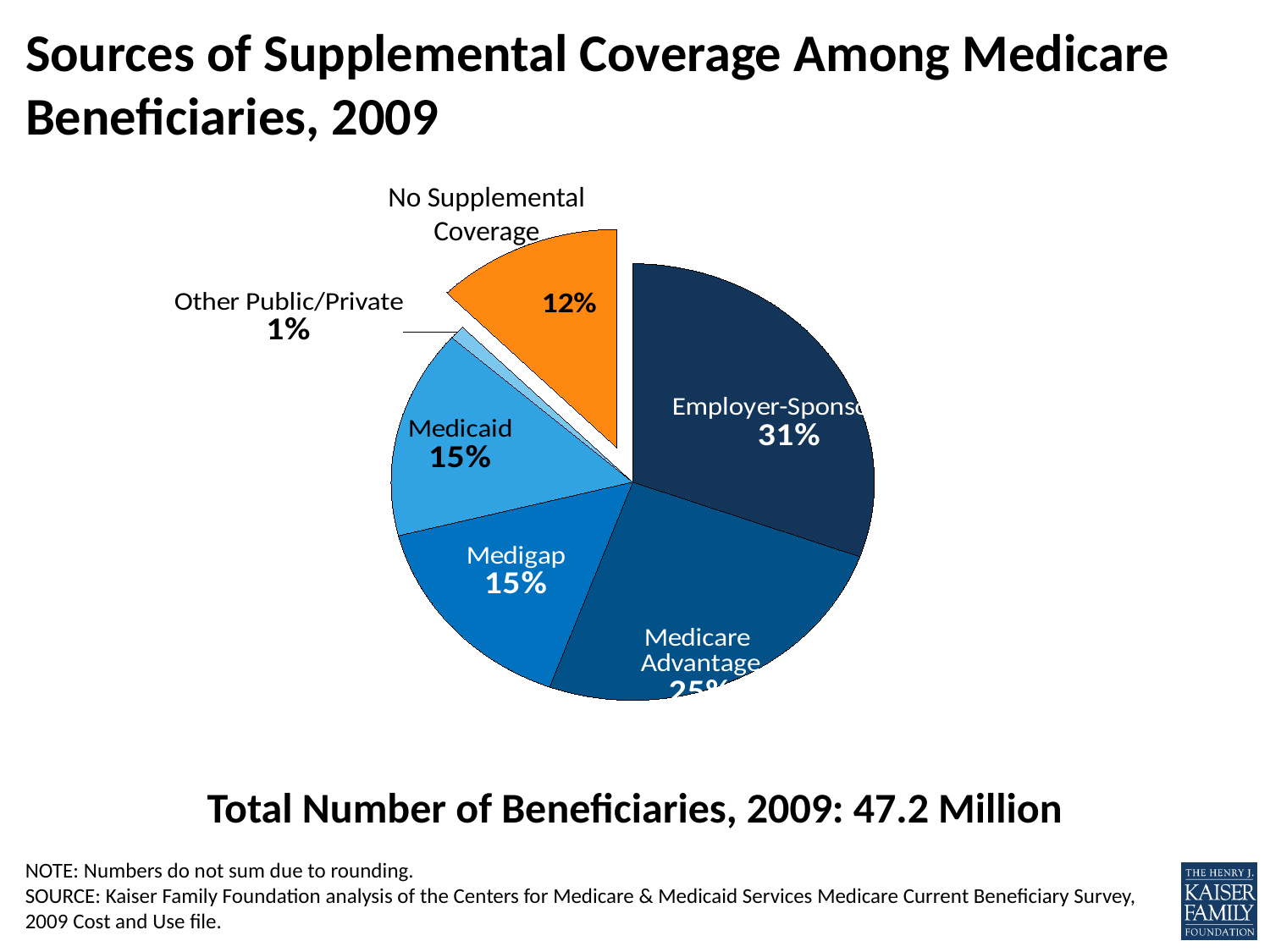
Which source of supplemental coverage has the smallest share of the pie? Other Public/Private (1%) Which is larger: the share with No Supplemental Coverage or the share with Medicaid? Medicaid Which source of supplemental coverage has the largest share of the pie? Employer-Sponsored (31%) What percentage of beneficiaries had Other Public/Private coverage? 1% What kind of chart is shown on the slide? Pie chart How many percentage points larger is the Employer-Sponsored share than the Medicare Advantage share? 6 percentage points How many slices does the pie chart have? 6 What percentage of beneficiaries had No Supplemental Coverage? 12% What percentage of beneficiaries were in Medicare Advantage? 25% What share of Medicare beneficiaries had Medicaid as their source of supplemental coverage in 2009? 15% What percentage of beneficiaries had Medigap coverage? 15% Which slice is coloured orange and pulled out from the rest of the pie? No Supplemental Coverage